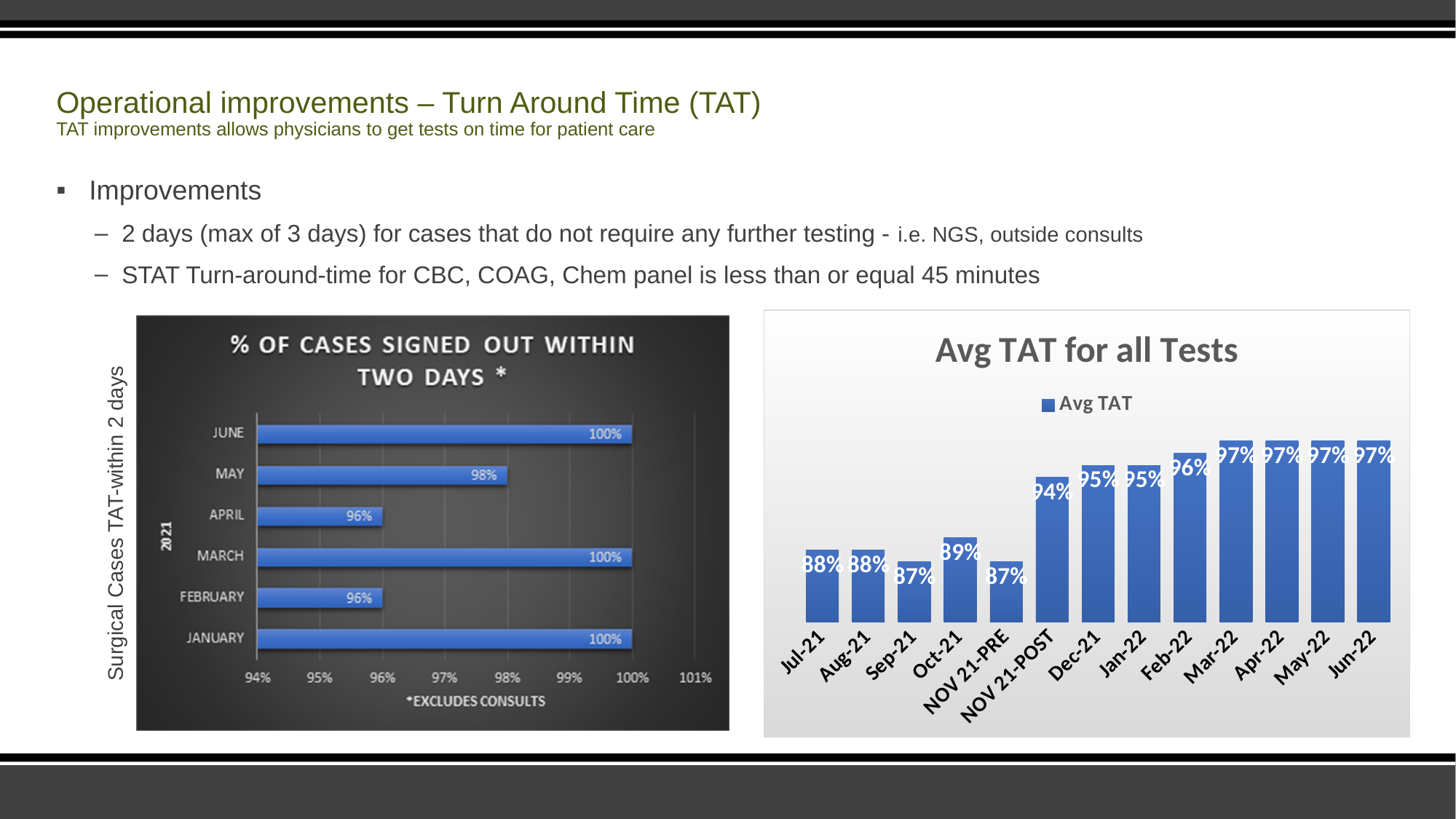
In the 'Avg TAT for all Tests' chart, which category has the lowest value, Sep-21 or Dec-21? Sep-21 In the 'Avg TAT for all Tests' chart, what is the value for Oct-21? 89% In the 'Avg TAT for all Tests' chart, how many categories are shown on the x axis? 13 In the '% of cases signed out within two days' chart, what is the value for May? 98% In the '% of cases signed out within two days' chart, which month has the lowest value, February or May? February In the '% of cases signed out within two days' chart, what is the difference between the values for June and May? 2% In the 'Avg TAT for all Tests' chart, what is the value for NOV 21-POST? 94% In the '% of cases signed out within two days' chart, what is the value for April? 96% In the '% of cases signed out within two days' chart, how many months are shown? 6 In the 'Avg TAT for all Tests' chart, how many series does the legend list? 1 In the 'Avg TAT for all Tests' chart, what is the difference between the values for NOV 21-POST and NOV 21-PRE? 7% What kind of chart is the '% of cases signed out within two days' chart? Bar chart